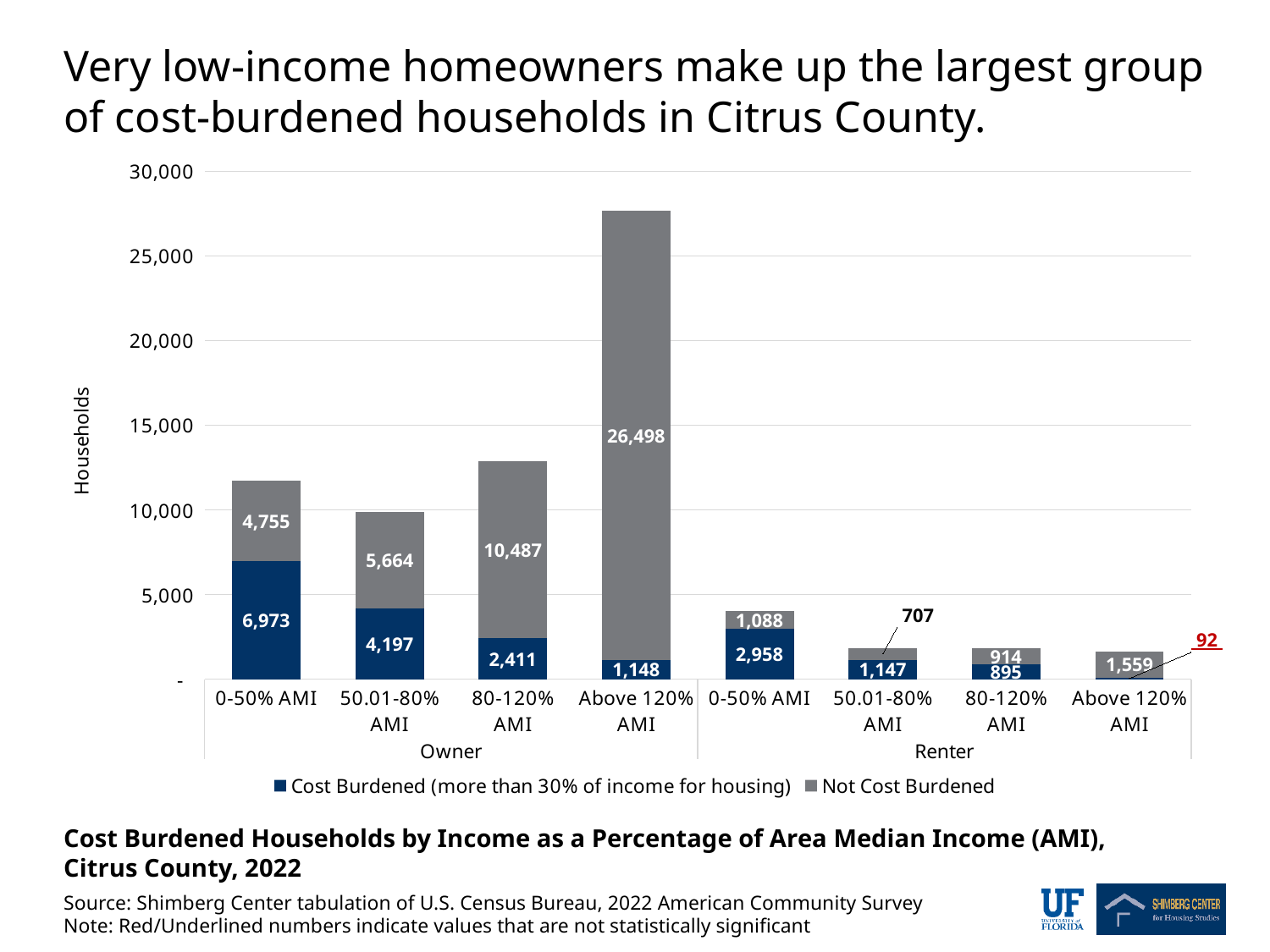
What kind of chart is shown on the slide? Stacked bar chart Which category has the largest number of cost-burdened households? Owner 0-50% AMI Which value on the chart is shown in red and underlined to indicate it is not statistically significant? 92 Which category has the smallest number of cost-burdened households? Renter Above 120% AMI How many not-cost-burdened owner households are in the Above 120% AMI category? 26,498 What is the difference between cost-burdened owner households at 0-50% AMI and cost-burdened owner households at 50.01-80% AMI? 2,776 How many cost-burdened renter households are in the 50.01-80% AMI category? 1,147 Which is larger: the number of cost-burdened renter households at 0-50% AMI or the number of cost-burdened owner households at 80-120% AMI? Cost-burdened renter households at 0-50% AMI How many cost-burdened owner households are in the 0-50% AMI category? 6,973 What is the total number of households (cost burdened plus not cost burdened) in the Owner 0-50% AMI category? 11,728 How many series does the legend list? 2 How many income categories are plotted across the Owner and Renter groups combined? 8